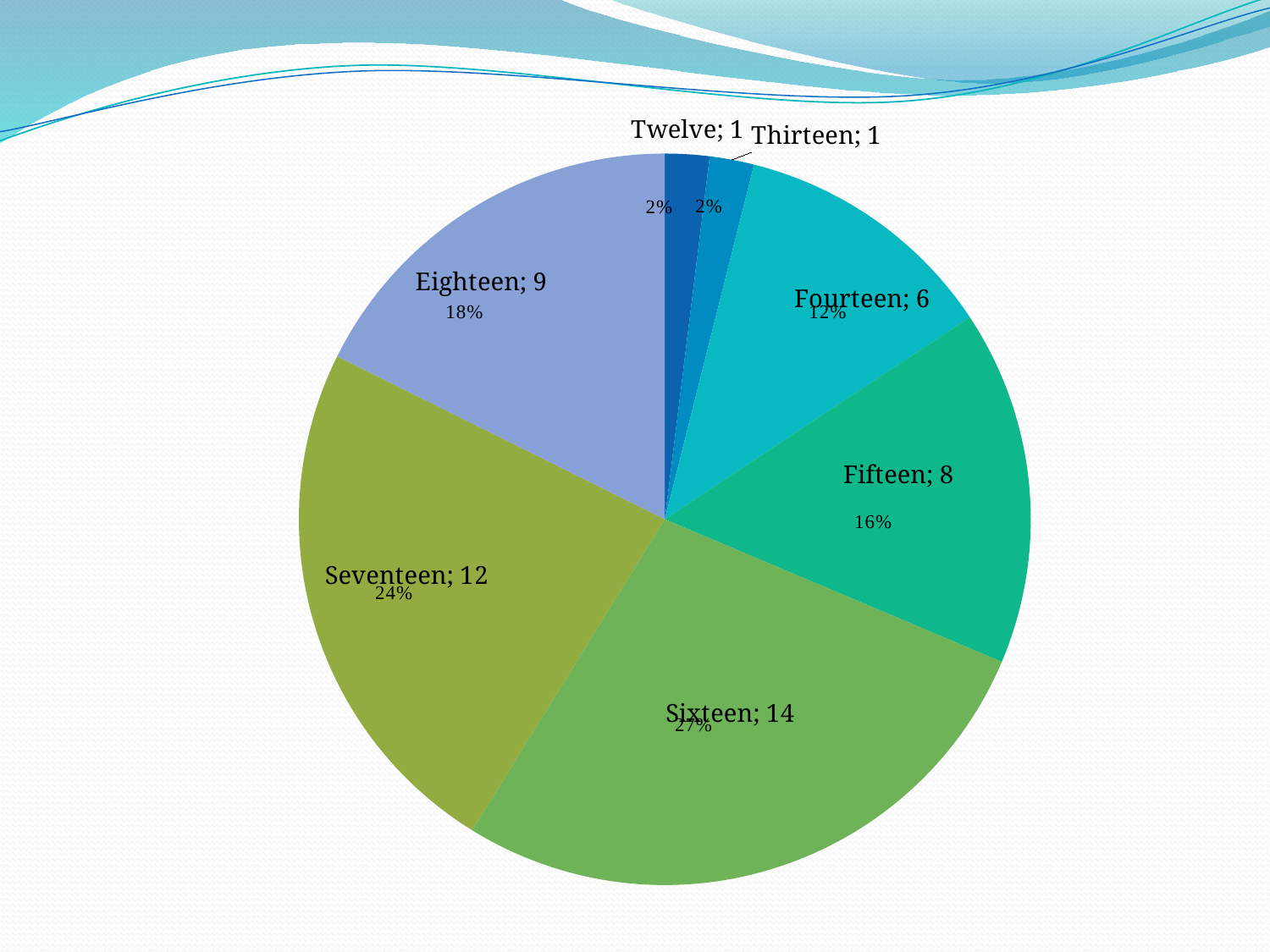
What is the value for Fourteen? 6 Which is larger, the value for Fifteen or the value for Fourteen? Fifteen What kind of chart is shown on the slide? pie chart What percentage share of the pie does Twelve have? 2% What is the difference between the values for Sixteen and Seventeen? 2 Which category has the largest slice of the pie? Sixteen What is the difference between the values for Eighteen and Fourteen? 3 What is the value for Sixteen? 14 How many slices does the pie chart have? 7 What percentage share of the pie does Fifteen have? 16% What is the value for Eighteen? 9 What percentage share of the pie does Seventeen have? 24%